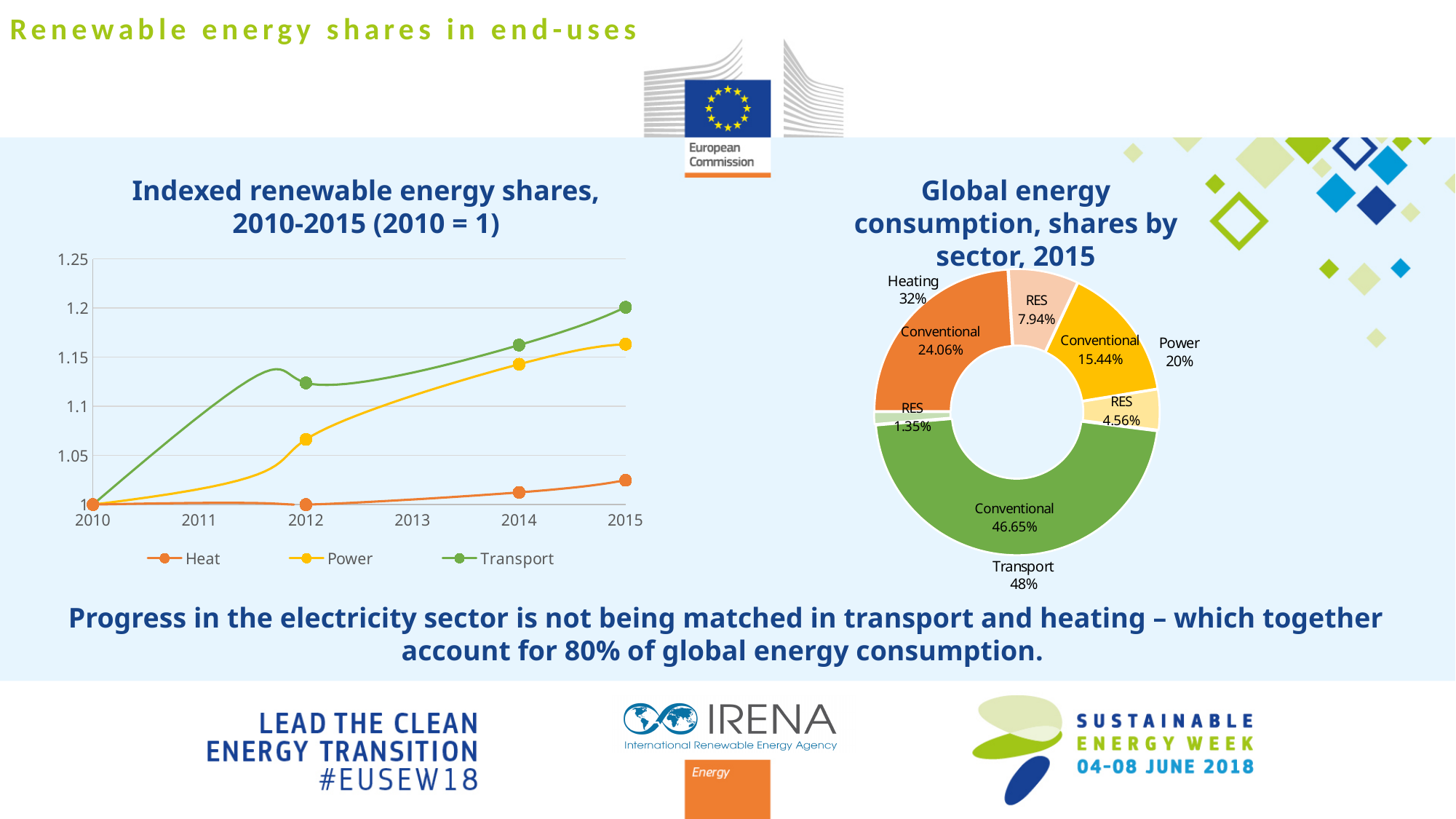
How many series does the legend of the 'Indexed renewable energy shares' chart list? 3 In the 'Global energy consumption, shares by sector, 2015' chart, what share does Transport account for? 48% What kind of chart is the 'Indexed renewable energy shares, 2010-2015' chart on the left? Line chart In the 'Indexed renewable energy shares' chart, does the Transport series rise or fall from 2010 to 2015? Rises In the 'Global energy consumption, shares by sector, 2015' chart, which is larger: the RES share in Heating or the RES share in Power? RES share in Heating (7.94%) In the 'Global energy consumption, shares by sector, 2015' chart, what is the difference between the Heating share and the Power share? 12 percentage points In the 'Global energy consumption, shares by sector, 2015' chart, what is the Conventional share within Heating? 24.06% In the 'Indexed renewable energy shares' chart, which series has the highest value in 2015? Transport In the 'Indexed renewable energy shares' chart, is the Transport value in 2015 greater or less than 1.15? greater In the 'Global energy consumption, shares by sector, 2015' chart, which sector has the smallest share? Power In the 'Indexed renewable energy shares' chart, is the Power value in 2012 greater or less than 1.1? less In the 'Indexed renewable energy shares' chart, which series has the lowest value in 2015? Heat